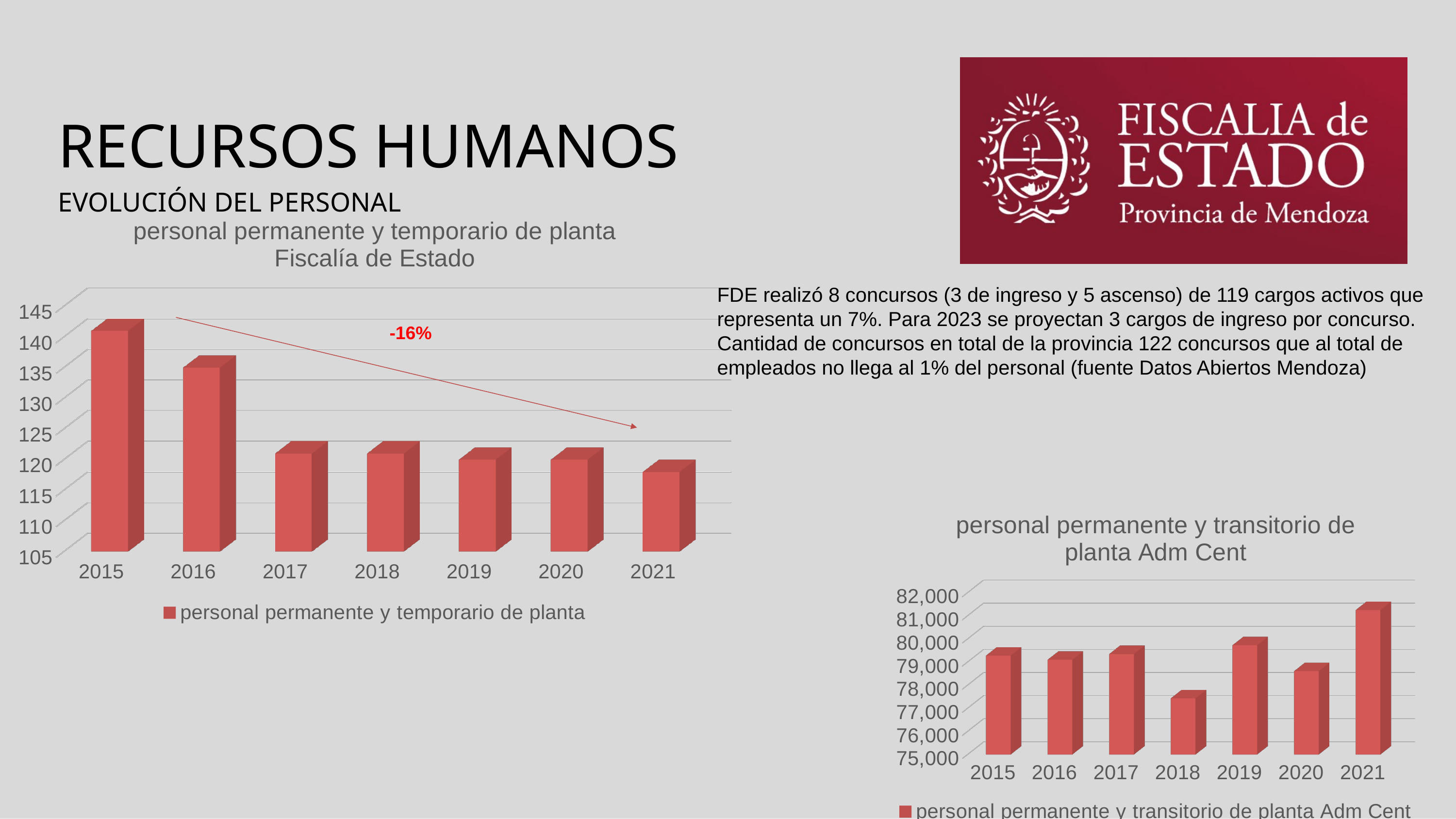
In the right chart (planta Adm Cent), which year has the lowest value? 2018 In the right chart (planta Adm Cent), how many series does the legend list? 1 In the left chart (Fiscalía de Estado), which year has the highest value? 2015 In the left chart (Fiscalía de Estado), how many years are shown on the x axis? 7 In the left chart (Fiscalía de Estado), which year has the lowest value? 2021 What kind of chart is the left chart titled 'personal permanente y temporario de planta Fiscalía de Estado'? bar chart In the right chart (planta Adm Cent), which year has the highest value? 2021 In the left chart (Fiscalía de Estado), do the values generally rise or fall from 2015 to 2021? fall In the left chart (Fiscalía de Estado), is the value for 2016 greater or less than 130? greater In the right chart (planta Adm Cent), is the value for 2021 greater or less than 80,000? greater In the left chart (Fiscalía de Estado), what percentage change is annotated in red next to the arrow? -16% In the left chart (Fiscalía de Estado), is the value for 2017 greater or less than 125? less